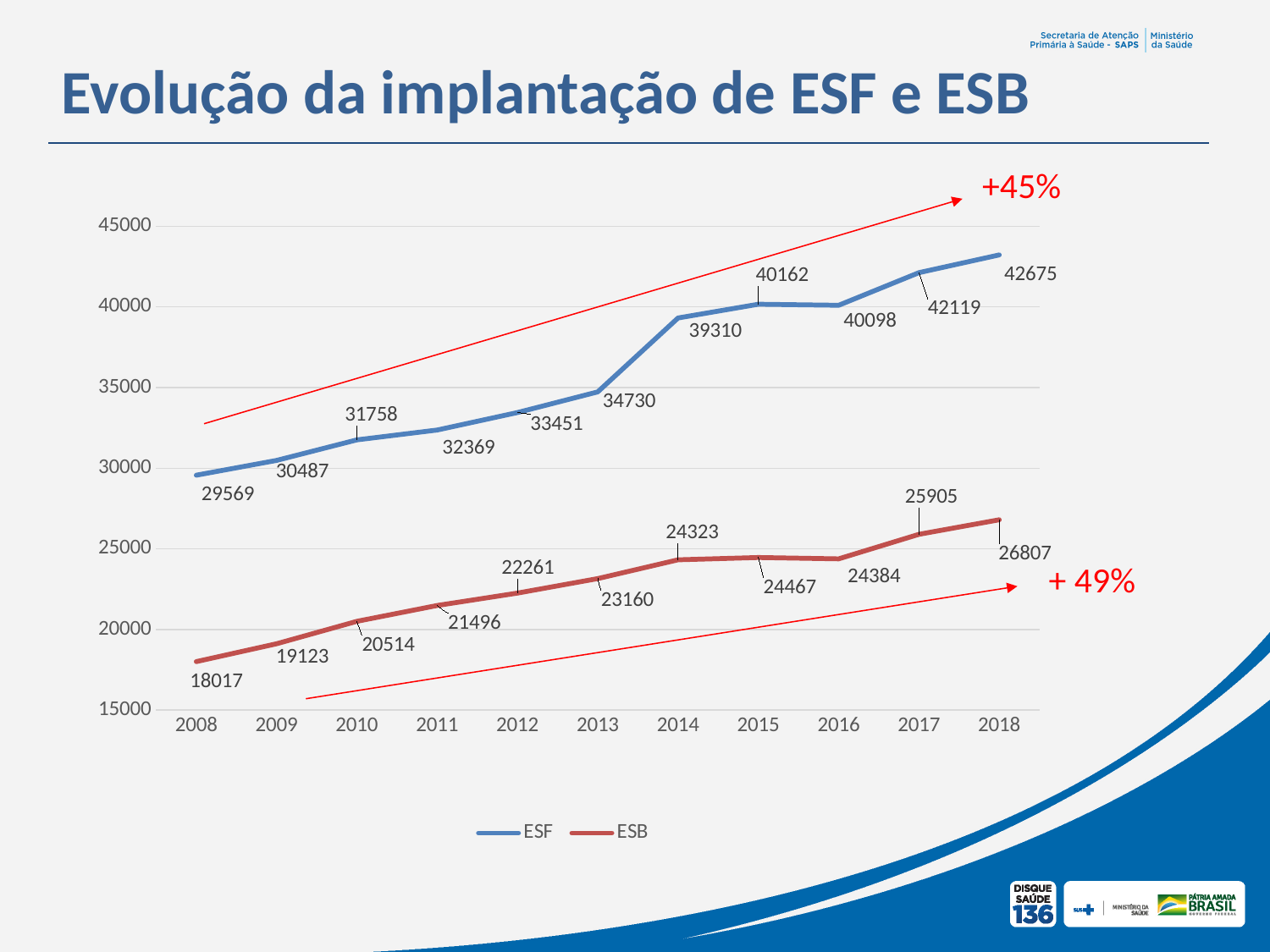
What is the ESB value for 2010? 20514 What kind of chart is shown on the slide? line chart How many years are shown on the x axis? 11 In which year is the ESF series at its lowest? 2008 Which is larger, the ESB value in 2015 or the ESB value in 2016? 2015 What percentage growth is annotated next to the ESB line? + 49% What is the ESF value for 2014? 39310 What is the difference between the ESF value in 2018 and the ESF value in 2008? 13106 How many series does the legend list? 2 What is the difference between the ESF and ESB values in 2013? 11570 In which year is the ESB series at its highest? 2018 What is the ESF value for 2008? 29569